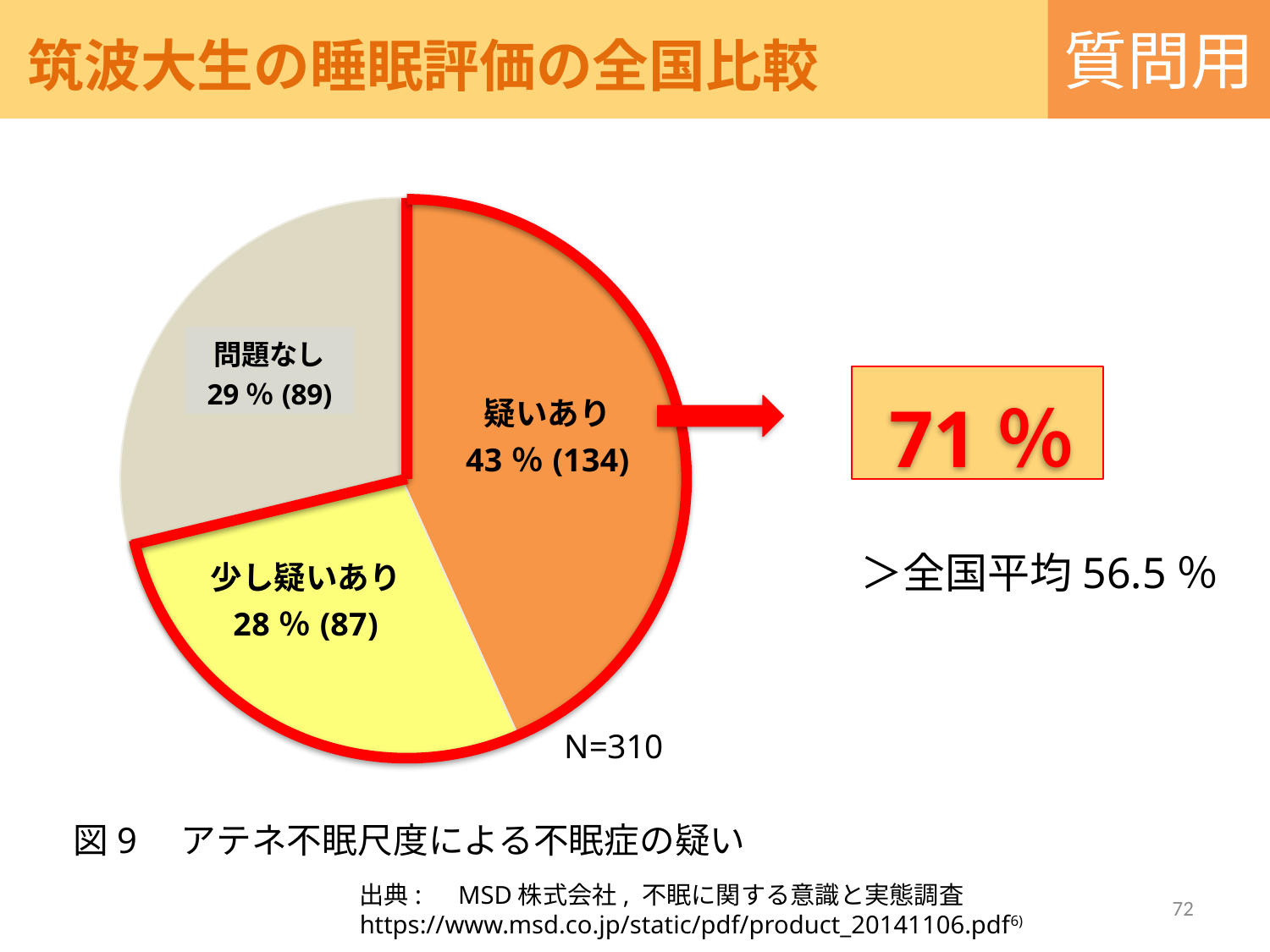
How many slices does the pie chart have? 3 What percentage does the 少し疑いあり slice represent? 28 % How many respondents are in the 問題なし slice? 89 Which slice of the pie chart is the smallest? 少し疑いあり What is the combined share of the 疑いあり and 少し疑いあり slices, as highlighted on the slide? 71 % What percentage does the 疑いあり slice represent? 43 % Which slice of the pie chart is the largest? 疑いあり What is the difference in percentage points between the 疑いあり slice and the 問題なし slice? 14 What kind of chart is shown on the slide? pie chart What is the total sample size (N) shown for the pie chart? 310 What percentage does the 問題なし slice represent? 29 % How many respondents are in the 疑いあり slice? 134